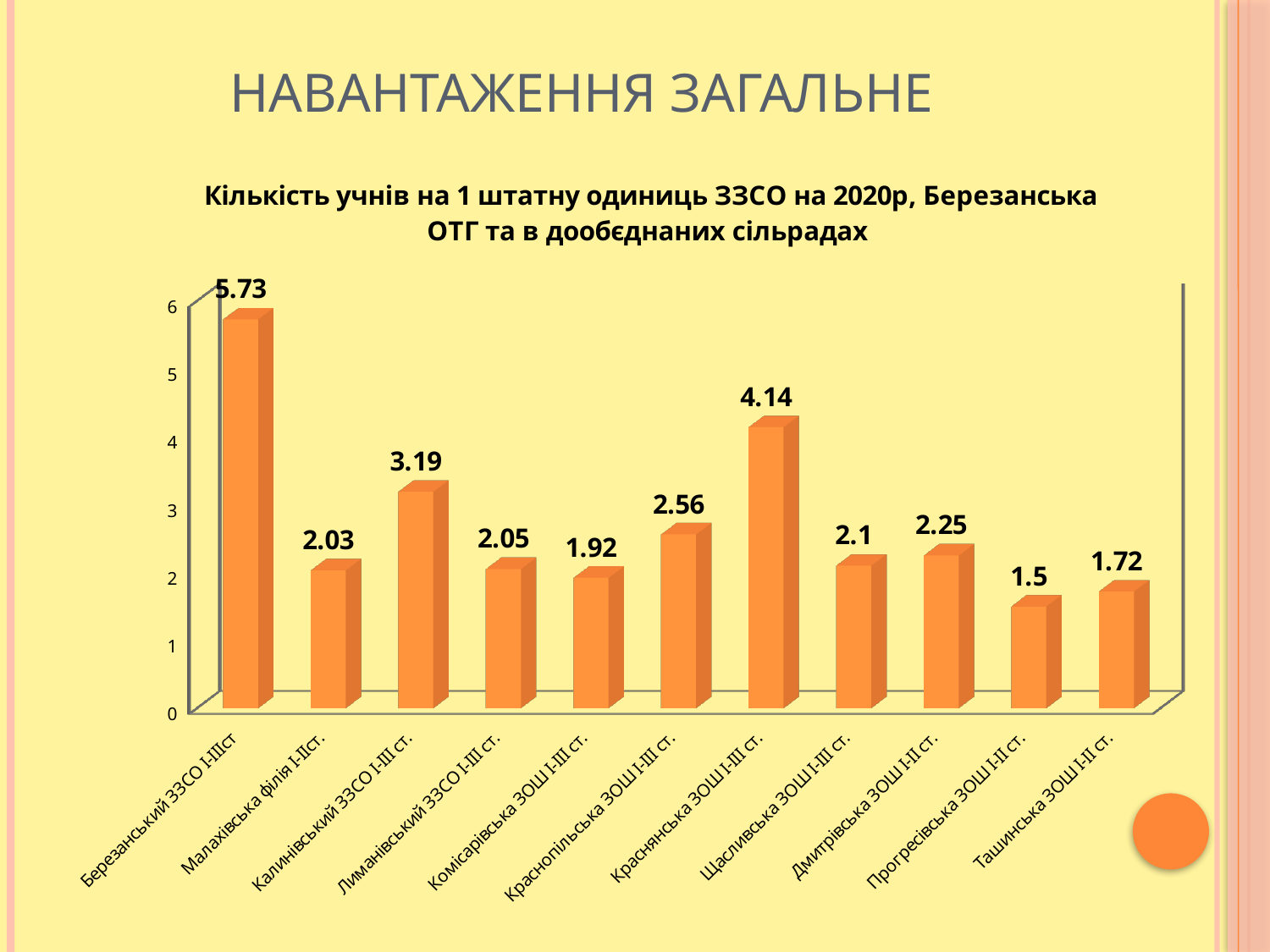
Is the value for Комісарівська ЗОШ І-ІІІ ст. greater or less than 2? less What is the difference between the values for Березанський ЗЗСО І-ІІІст and Краснянська ЗОШ І-ІІІ ст.? 1.59 What is the value for Малахівська філія І-ІІст.? 2.03 What is the value for Прогресівська ЗОШ І-ІІ ст.? 1.5 What is the difference between the values for Ташинська ЗОШ І-ІІ ст. and Прогресівська ЗОШ І-ІІ ст.? 0.22 What is the value for Краснянська ЗОШ І-ІІІ ст.? 4.14 What is the value for Калинівський ЗЗСО І-ІІІ ст.? 3.19 How many categories are shown on the chart? 11 Which category has the lowest value? Прогресівська ЗОШ І-ІІ ст. Which category has the highest value? Березанський ЗЗСО І-ІІІст What kind of chart is shown on the slide? bar chart Which is larger, the value for Краснопільська ЗОШ І-ІІІ ст. or the value for Дмитрівська ЗОШ І-ІІ ст.? Краснопільська ЗОШ І-ІІІ ст.